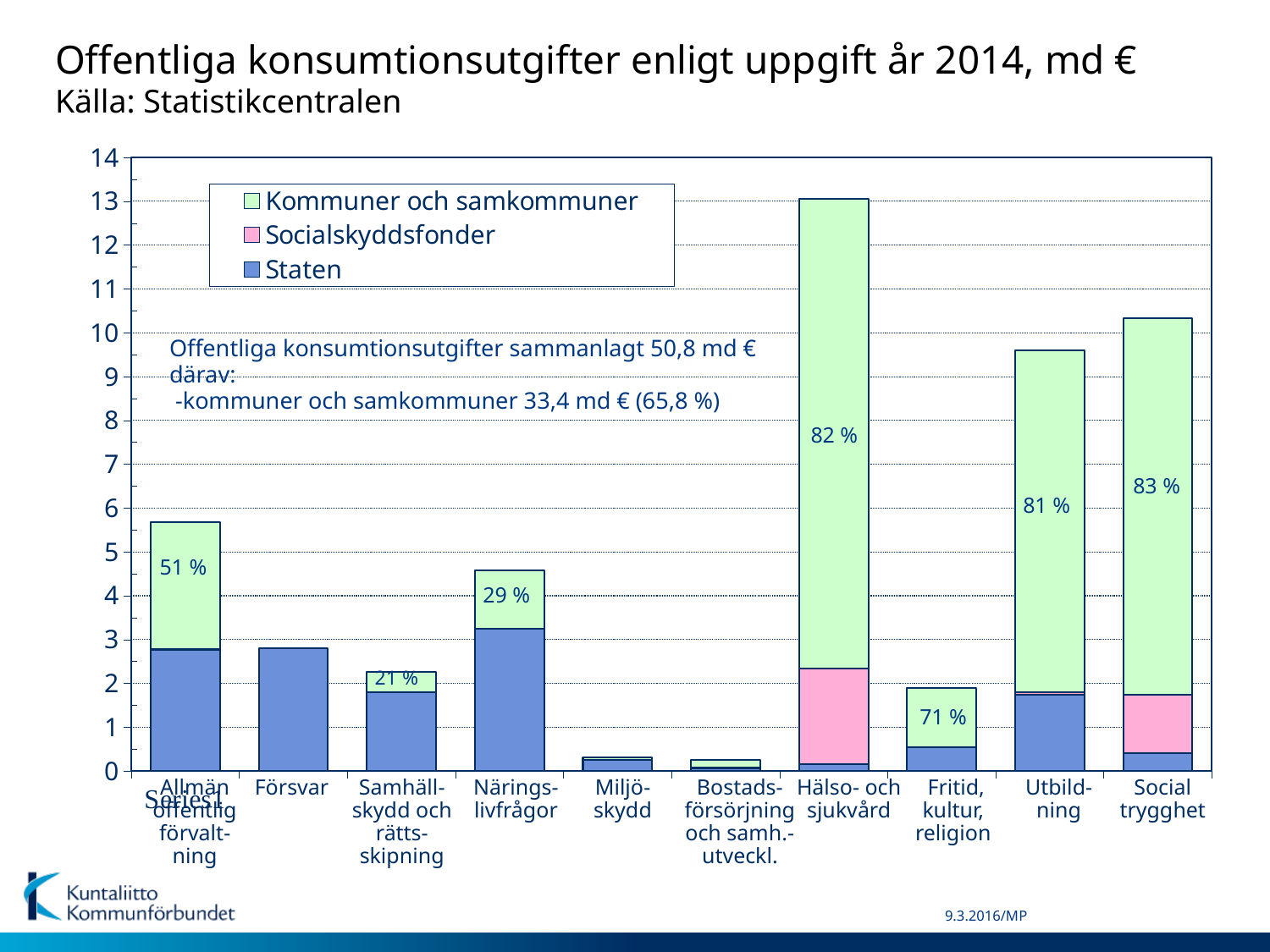
How many categories are shown along the x axis? 10 What percentage label is shown on the bar for Näringslivfrågor? 29 % Is the total value for Försvar greater or less than 4? less Is the total value for Hälso- och sjukvård greater or less than 12? greater What percentage label is shown on the bar for Social trygghet? 83 % Which stacked bar is taller, Utbildning or Social trygghet? Social trygghet How many series does the legend list? 3 What kind of chart is shown on the slide? bar chart Which category has the tallest stacked bar? Hälso- och sjukvård What percentage label is shown on the bar for Hälso- och sjukvård? 82 % What percentage label is shown on the bar for Fritid, kultur, religion? 71 % Which series is shown in light green in the legend? Kommuner och samkommuner